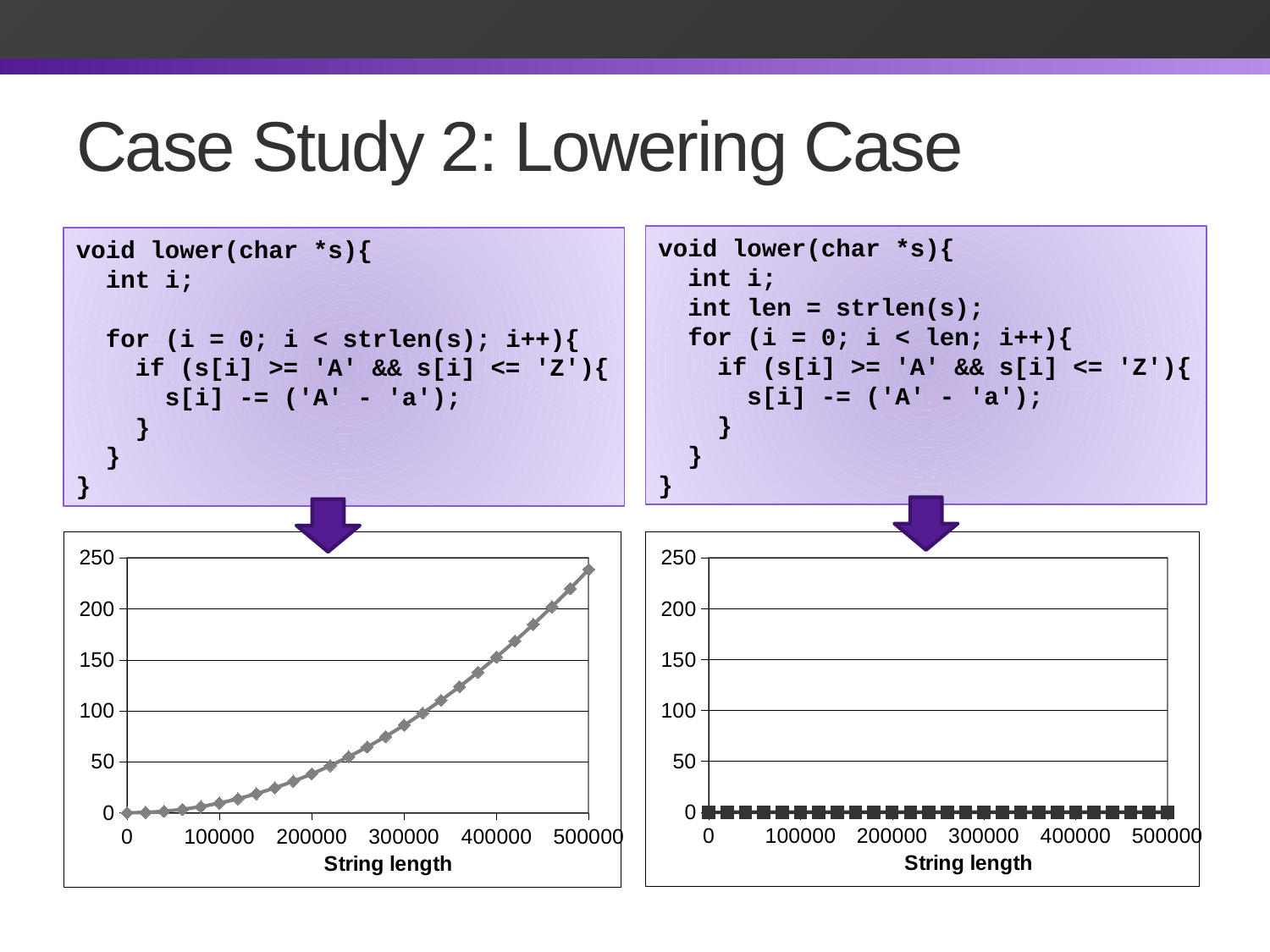
In the left chart, is the value at a string length of 500000 greater or less than 200? greater In the left chart, is the value at a string length of 400000 greater or less than 100? greater In the left chart, is the value at a string length of 100000 greater or less than 50? less What is the x-axis title of the left chart? String length In the left chart, do the values rise or fall as string length increases? rise What kind of chart is the left chart below the code? line chart In the left chart, which string length has the larger value, 100000 or 500000? 500000 In the right chart, do the values rise, fall, or stay flat as string length increases? stay flat At a string length of 500000, which chart shows the larger value, the left chart or the right chart? the left chart What is the highest tick value shown on the y-axis of the right chart? 250